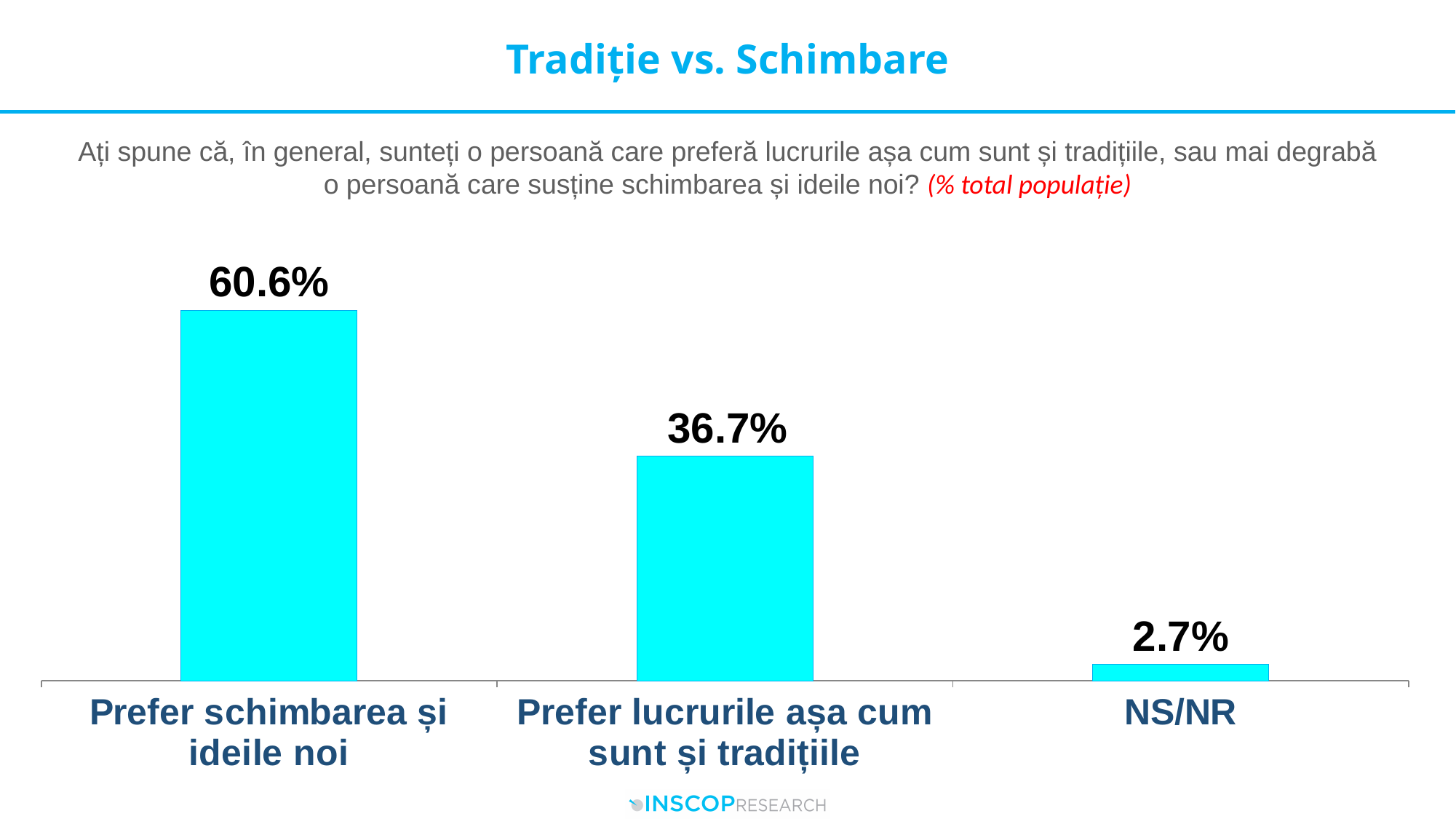
What is the difference between the values for "Prefer lucrurile așa cum sunt și tradițiile" and "NS/NR"? 34.0% What is the value for "Prefer lucrurile așa cum sunt și tradițiile"? 36.7% What is the value for "Prefer schimbarea și ideile noi"? 60.6% How many categories are shown in the chart? 3 Which is larger: the value for "Prefer schimbarea și ideile noi" or the value for "Prefer lucrurile așa cum sunt și tradițiile"? Prefer schimbarea și ideile noi What is the difference between the values for "Prefer schimbarea și ideile noi" and "Prefer lucrurile așa cum sunt și tradițiile"? 23.9% What is the title of the slide? Tradiție vs. Schimbare What is the value for "NS/NR"? 2.7% Which category has the highest value? Prefer schimbarea și ideile noi What kind of chart is shown on the slide? Bar chart Which category has the lowest value? NS/NR What colour are the bars in the chart? Cyan